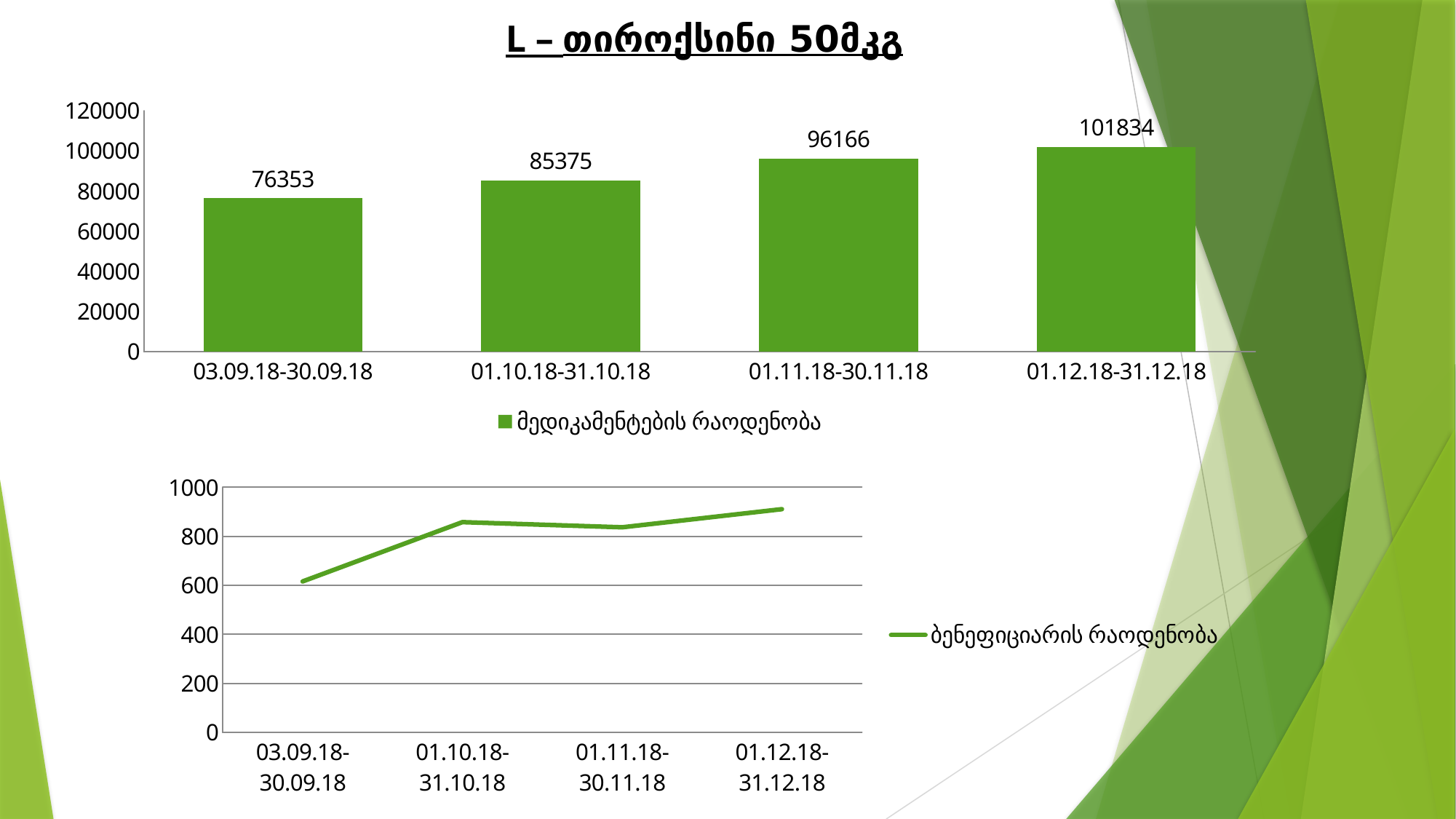
In the top bar chart, do the values rise or fall from left to right along the x axis? rise In the top bar chart, which period has the lowest value? 03.09.18-30.09.18 In the top bar chart, what is the value for 03.09.18-30.09.18? 76353 In the bottom line chart, is the value for 03.09.18-30.09.18 greater or less than 800? less What kind of chart is the bottom chart on the slide? line chart In the top bar chart, what is the difference between the values for 01.12.18-31.12.18 and 01.10.18-31.10.18? 16459 In the top bar chart, what is the value for 01.11.18-30.11.18? 96166 In the top bar chart, which is larger: the value for 01.10.18-31.10.18 or the value for 01.11.18-30.11.18? 01.11.18-30.11.18 In the bottom line chart, which period has the lowest value? 03.09.18-30.09.18 What is the legend entry of the bottom line chart? ბენეფიციარის რაოდენობა How many bars are in the top bar chart? 4 In the top bar chart, which period has the highest value? 01.12.18-31.12.18